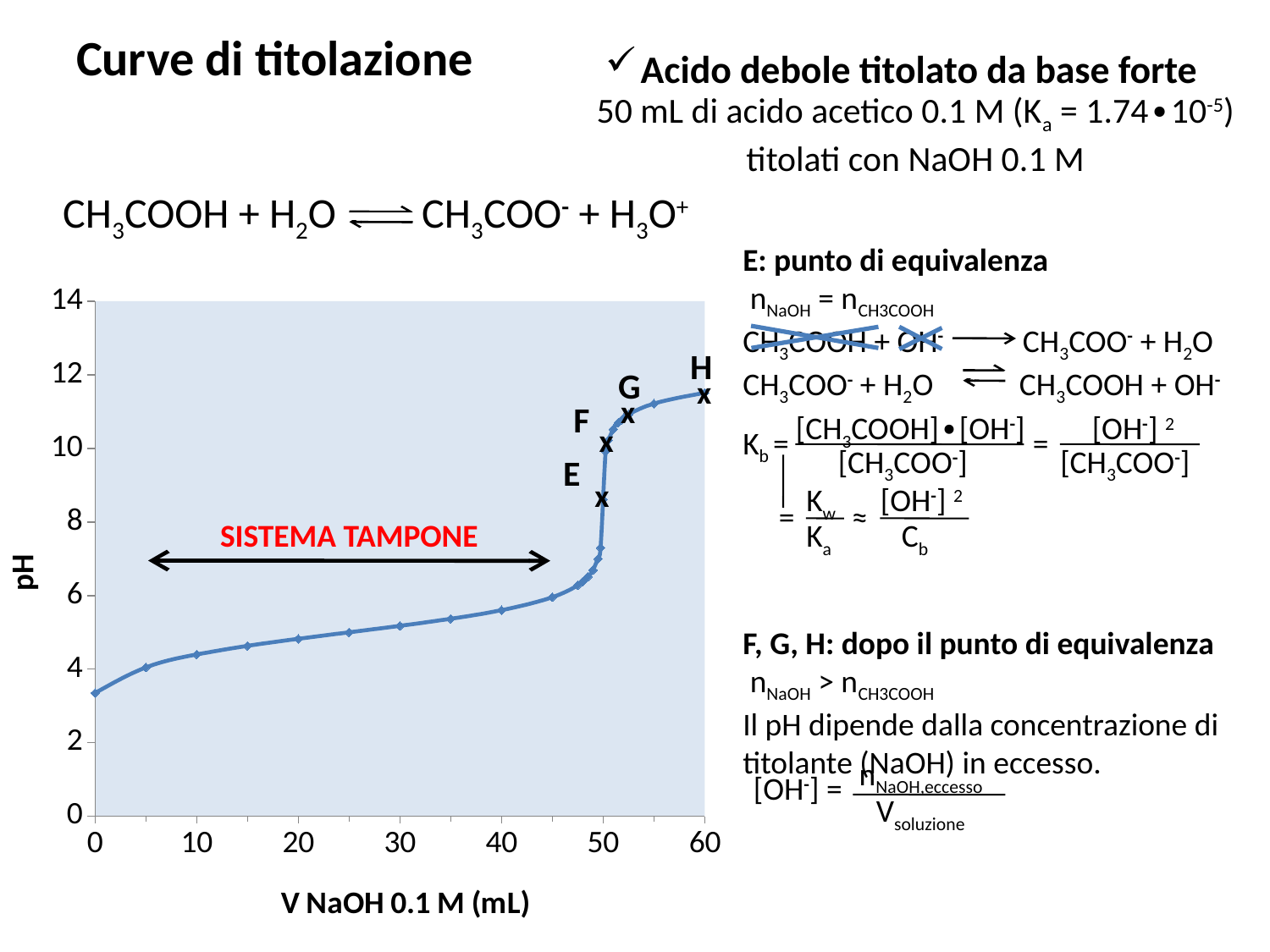
At which volume of NaOH on the x axis is the pH highest? 60 What is the label of the x axis of the chart? V NaOH 0.1 M (mL) Is the pH at 60 mL of NaOH greater or less than 10? greater Is the pH at 0 mL of NaOH greater or less than 4? less What kind of chart is shown on the slide? line chart Which is larger, the pH at 60 mL of NaOH or the pH at 0 mL of NaOH? 60 mL How many points on the curve are marked with letters (E, F, G, H)? 4 Is the pH at point G greater or less than 10? greater What is the label of the y axis of the chart? pH Does the pH rise or fall as the volume of NaOH increases along the x axis? rise